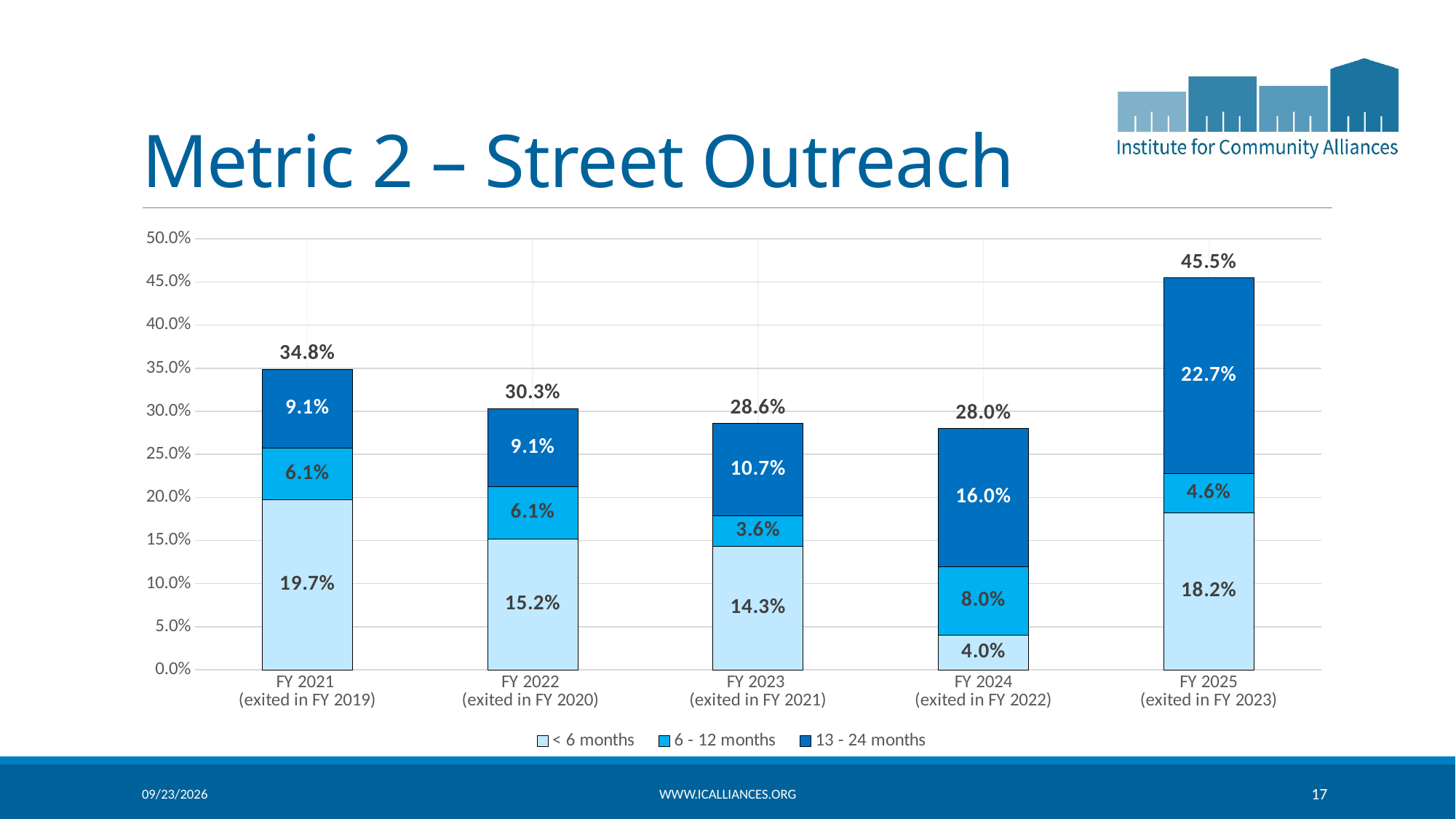
Which fiscal year has the lowest stacked bar total? FY 2024 What is the value for the '6 - 12 months' series in FY 2023? 3.6% What is the difference between the '13 - 24 months' values for FY 2025 and FY 2024? 6.7% What is the total of the stacked bar for FY 2024? 28.0% Which fiscal year has the highest stacked bar total? FY 2025 How many fiscal years are shown on the x axis? 5 Is the total for FY 2025 greater or less than 40.0%? greater What is the value for the '< 6 months' series in FY 2021? 19.7% How many series does the legend list? 3 What kind of chart is shown on the slide? Stacked bar chart What is the value for the '13 - 24 months' series in FY 2025? 22.7% Which is larger: the '< 6 months' value for FY 2022 or for FY 2023? FY 2022